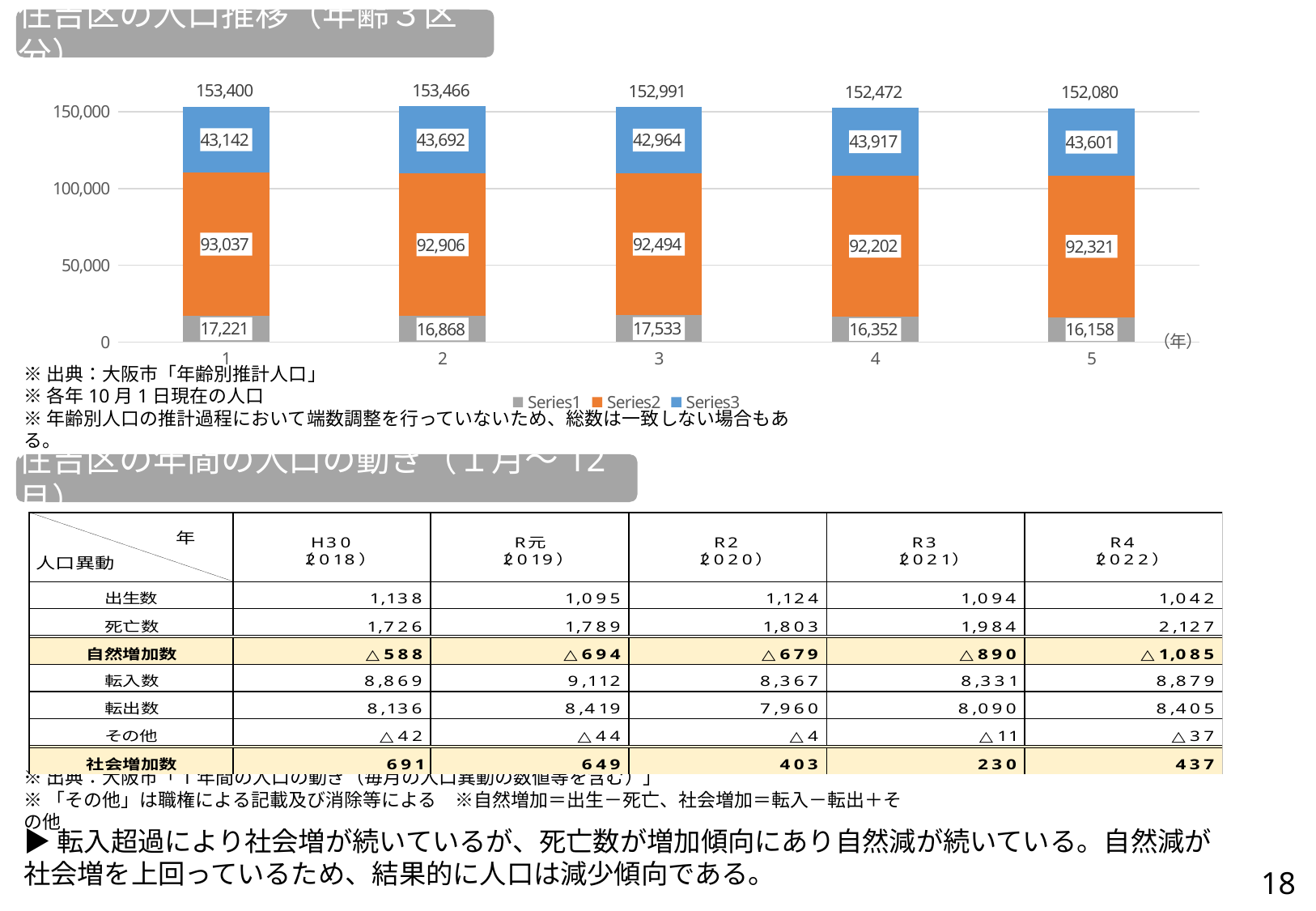
Which is larger, the Series1 value for category 1 or for category 2? category 1 What is the value of Series3 for category 2? 43,692 How many series does the chart legend list? 3 What is the value of Series1 for category 5? 16,158 What type of chart is shown on the slide? stacked bar chart How many categories are shown on the x axis of the chart? 5 What is the difference between the Series3 values for category 4 and category 3? 953 Which category has the lowest value for Series2? 4 What is the value of Series2 for category 3? 92,494 Do the bar totals rise or fall from category 2 to category 5? fall What is the total of the stacked bar for category 4? 152,472 Which category has the highest value for Series1? 3